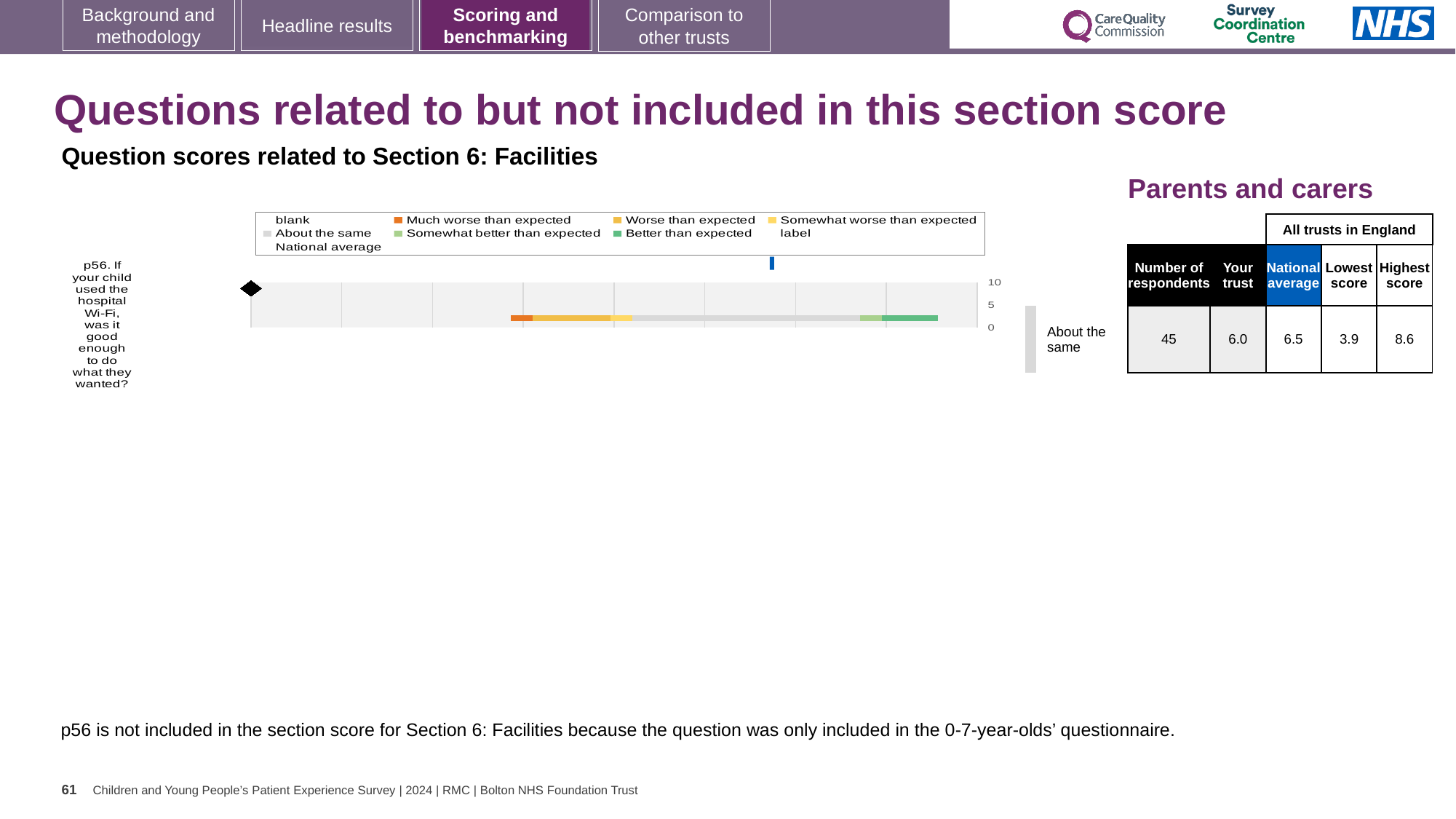
In the table beside the chart, which is larger for p56: the 'Your trust' score or the National average? National average Which question is plotted on the chart? p56. If your child used the hospital Wi-Fi, was it good enough to do what they wanted? In the table beside the chart, how many respondents answered p56? 45 How many entries does the chart legend list? 9 In the table beside the chart, what is the difference between the Highest score and the Lowest score for p56? 4.7 What colour does the legend use for 'Much worse than expected'? orange According to the table beside the chart, how is the trust's p56 result categorised? About the same What is the highest value shown on the chart's numeric axis? 10 What kind of chart is shown on the slide for question p56? bar chart How many questions (categories) are plotted on the chart? 1 In the table beside the chart, what is the National average score for p56? 6.5 In the table beside the chart, what is the 'Your trust' score for p56? 6.0